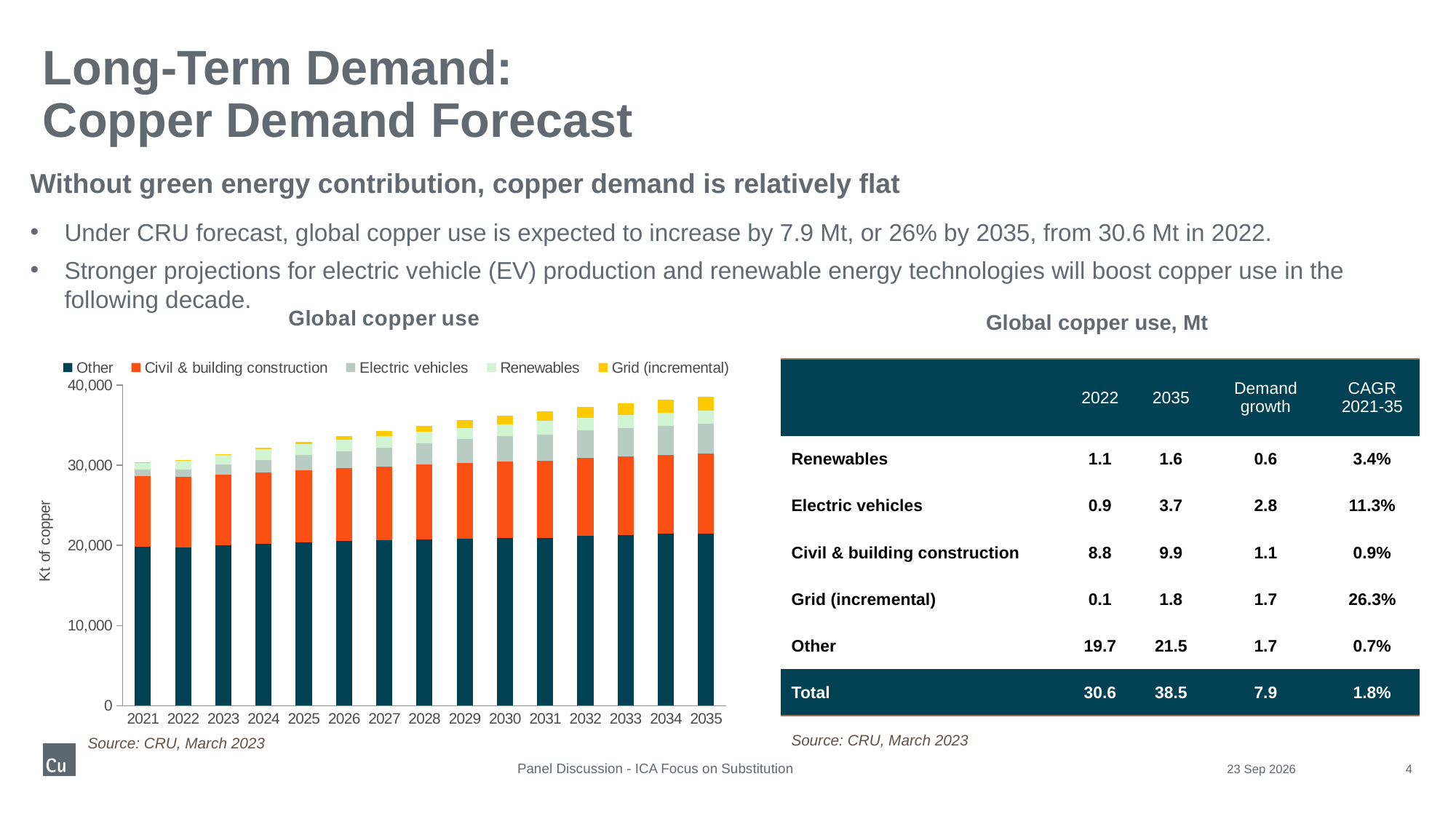
Which is larger in the Global copper use chart, the total bar for 2021 or the total bar for 2035? 2035 What is the title of the chart on the slide? Global copper use How many series does the legend of the Global copper use chart list? 5 How many years are shown on the x axis of the Global copper use chart? 15 Do the total bar heights in the Global copper use chart rise or fall from 2021 to 2035? Rise What kind of chart is shown on the slide? Stacked bar chart What is the label on the y axis of the Global copper use chart? Kt of copper Is the total bar height for 2035 in the Global copper use chart greater or less than 40,000? less Is the Other segment for 2035 in the Global copper use chart greater or less than 20,000? greater Which year has the shortest stacked bar in the Global copper use chart? 2021 Is the total bar height for 2035 in the Global copper use chart greater or less than 30,000? greater Which year has the tallest stacked bar in the Global copper use chart? 2035